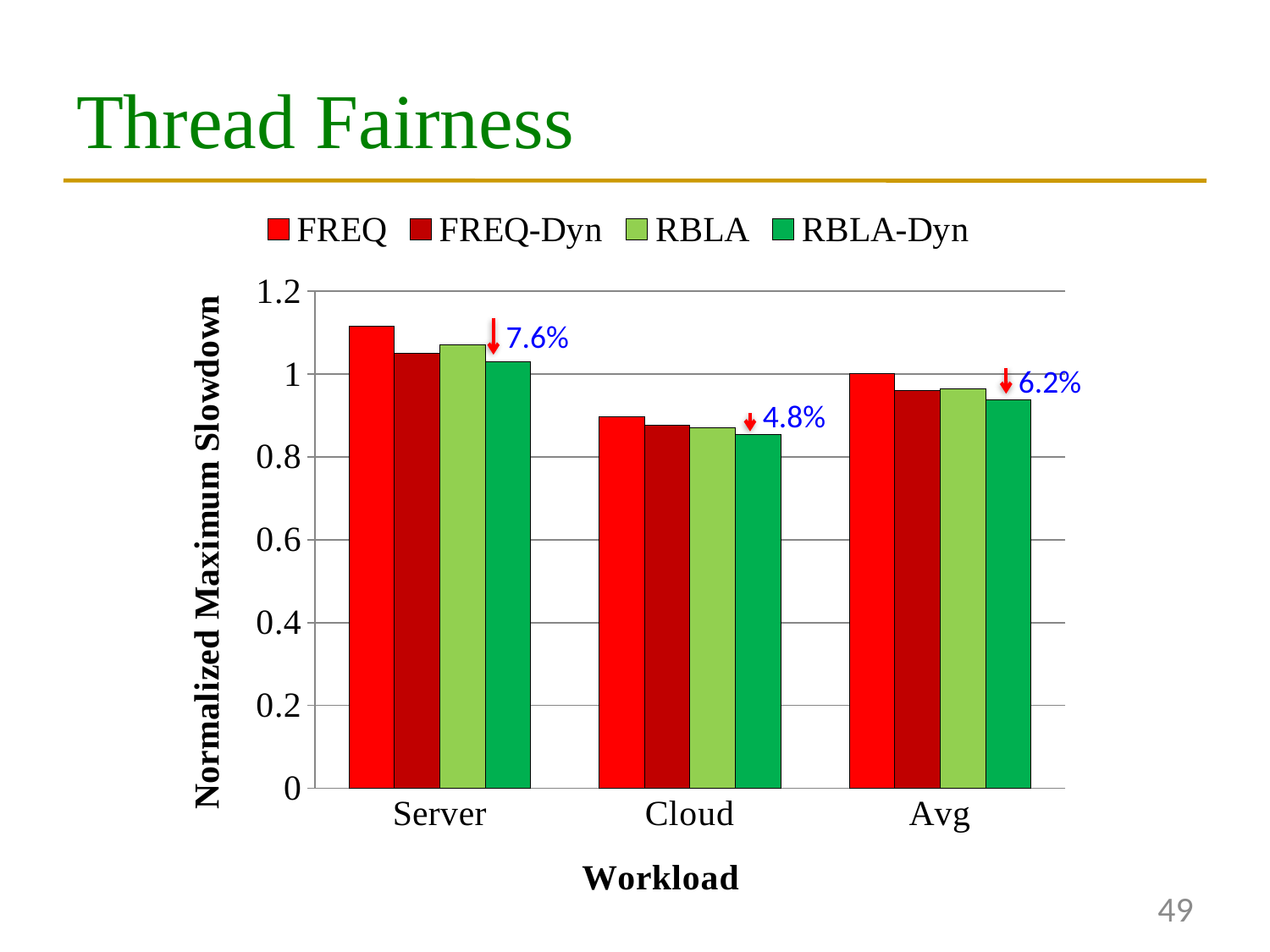
Is the RBLA-Dyn value for Cloud greater or less than 1? less What percentage reduction is annotated above the Server group? 7.6% Which workload has the lowest FREQ value? Cloud How many workload categories are shown on the x axis? 3 What percentage reduction is annotated above the Avg group? 6.2% What is the y-axis title of the chart? Normalized Maximum Slowdown Is the RBLA-Dyn value for Avg greater or less than 1? less Which workload has the highest FREQ value? Server Is the FREQ value for Server greater or less than 1? greater What kind of chart is shown on the slide? bar chart What percentage reduction is annotated above the Cloud group? 4.8% How many series does the legend list? 4